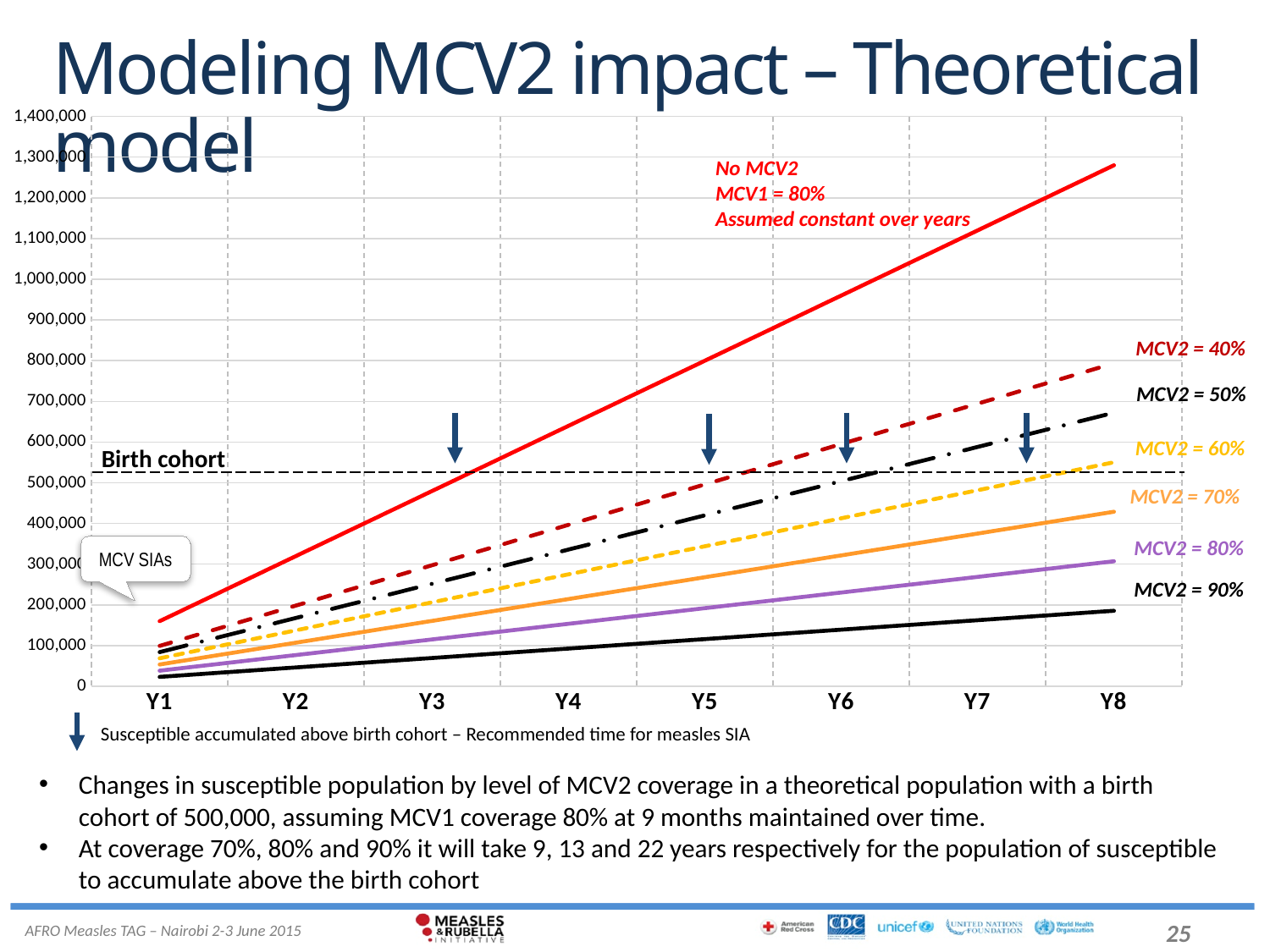
How many years (Y1 to Y8) are shown on the x axis of the chart? 8 How many lines (series) are labelled on the chart? 7 Does the No MCV2 line rise or fall from Y1 to Y8? rise Is the value of the No MCV2 line at Y1 greater or less than 200,000? less Is the value of the No MCV2 line at Y8 greater or less than 1,200,000? greater At Y8, which is larger: the MCV2 = 50% line or the MCV2 = 70% line? MCV2 = 50% Is the value of the MCV2 = 90% line at Y8 greater or less than 300,000? less Which series has the highest value at Y8? No MCV2 What is the label of the horizontal dashed reference line on the chart? Birth cohort What kind of chart is shown on the slide? line chart Which series has the lowest value at Y8? MCV2 = 90%